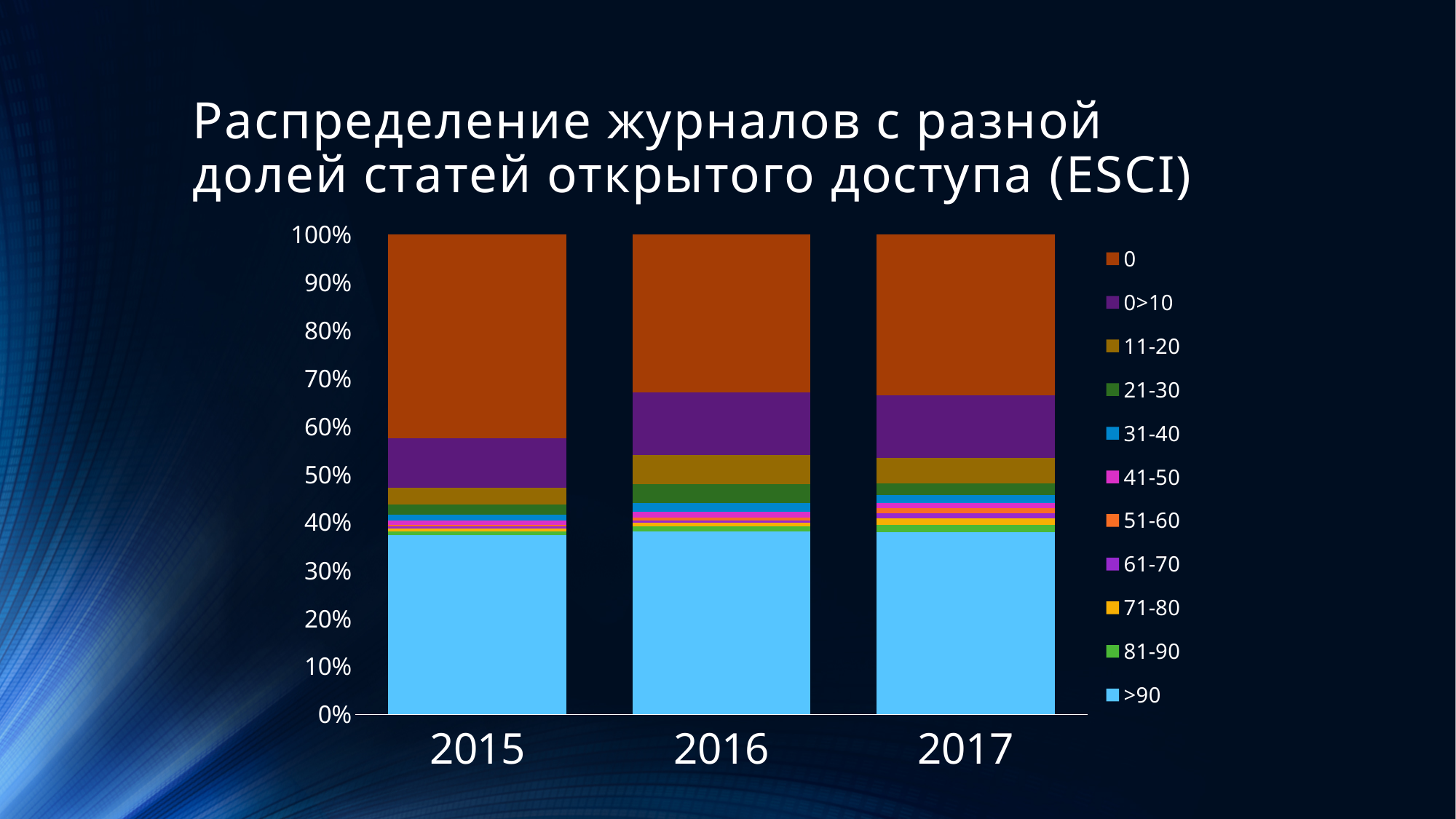
Is the share of the "0" segment in the 2015 bar greater or less than 30%? greater How many series does the chart's legend list? 11 Which series has the largest segment in the 2015 bar? 0 Which series has the largest segment in the 2016 bar? >90 Is the "0>10" segment larger in the 2015 bar or in the 2016 bar? 2016 What is the title of the chart on the slide? Распределение журналов с разной долей статей открытого доступа (ESCI) Which legend entry is shown at the bottom of the legend? >90 Is the share of the "0" segment in the 2016 bar greater or less than 40%? less How many years are shown on the x axis of the chart? 3 Is the share of the ">90" segment in the 2015 bar greater or less than 50%? less Is the "0" segment larger in the 2015 bar or in the 2016 bar? 2015 What kind of chart is shown on the slide? stacked bar chart